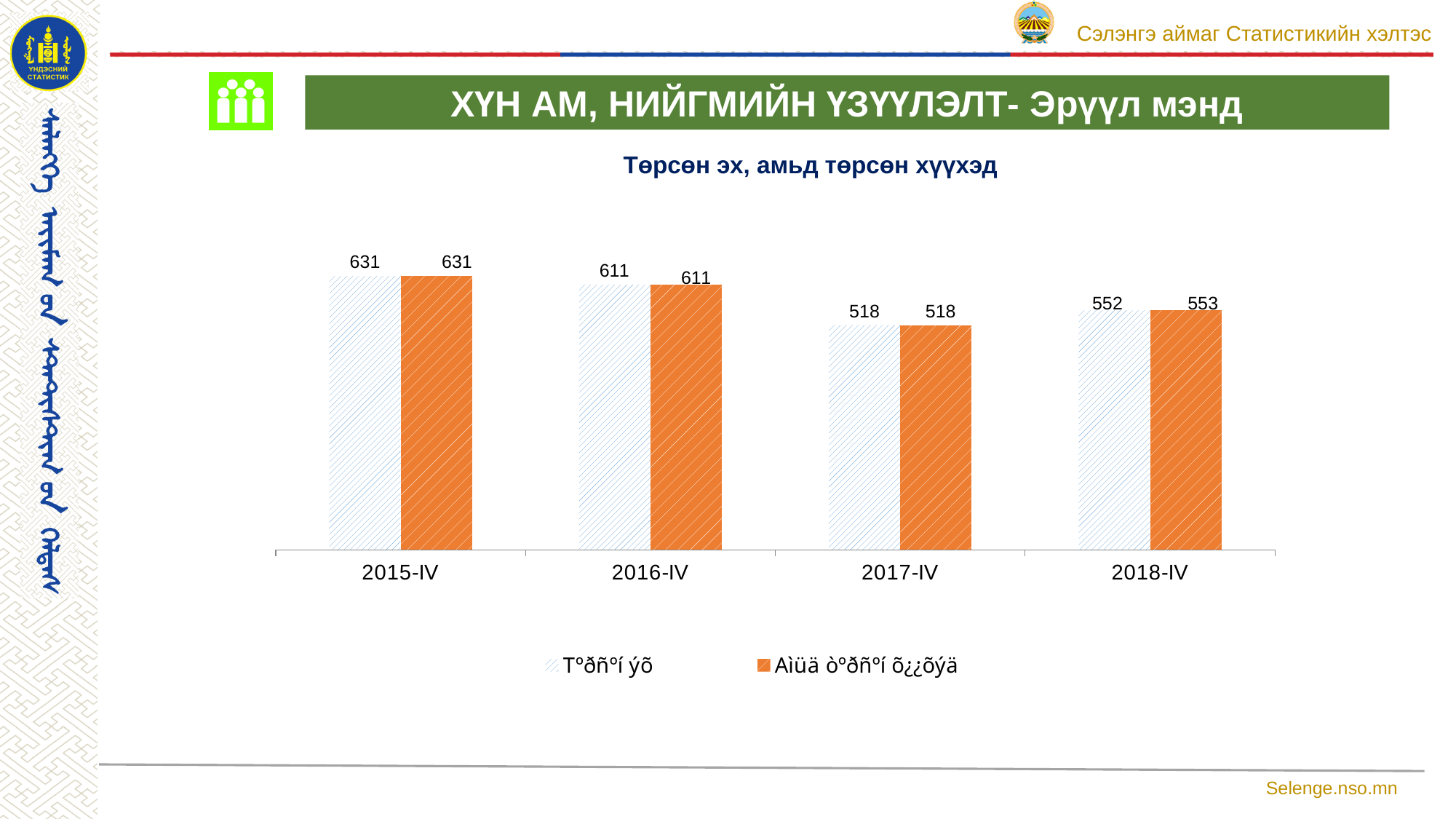
Which is larger, the orange bar for 2016-IV or the orange bar for 2018-IV? 2016-IV Which period has the lowest value for the blue hatched bars? 2017-IV How many periods are shown on the x axis? 4 Which period has the highest value for the orange bars? 2015-IV Do the blue hatched bar values rise or fall from 2015-IV to 2017-IV? fall What kind of chart is shown on the slide? bar chart What is the difference between the orange bar values for 2015-IV and 2018-IV? 78 What is the difference between the blue hatched bar values for 2016-IV and 2017-IV? 93 What is the value of the blue hatched bar for 2017-IV? 518 What is the value of the blue hatched bar for 2015-IV? 631 What is the value of the orange bar for 2018-IV? 553 How many series does the legend list? 2